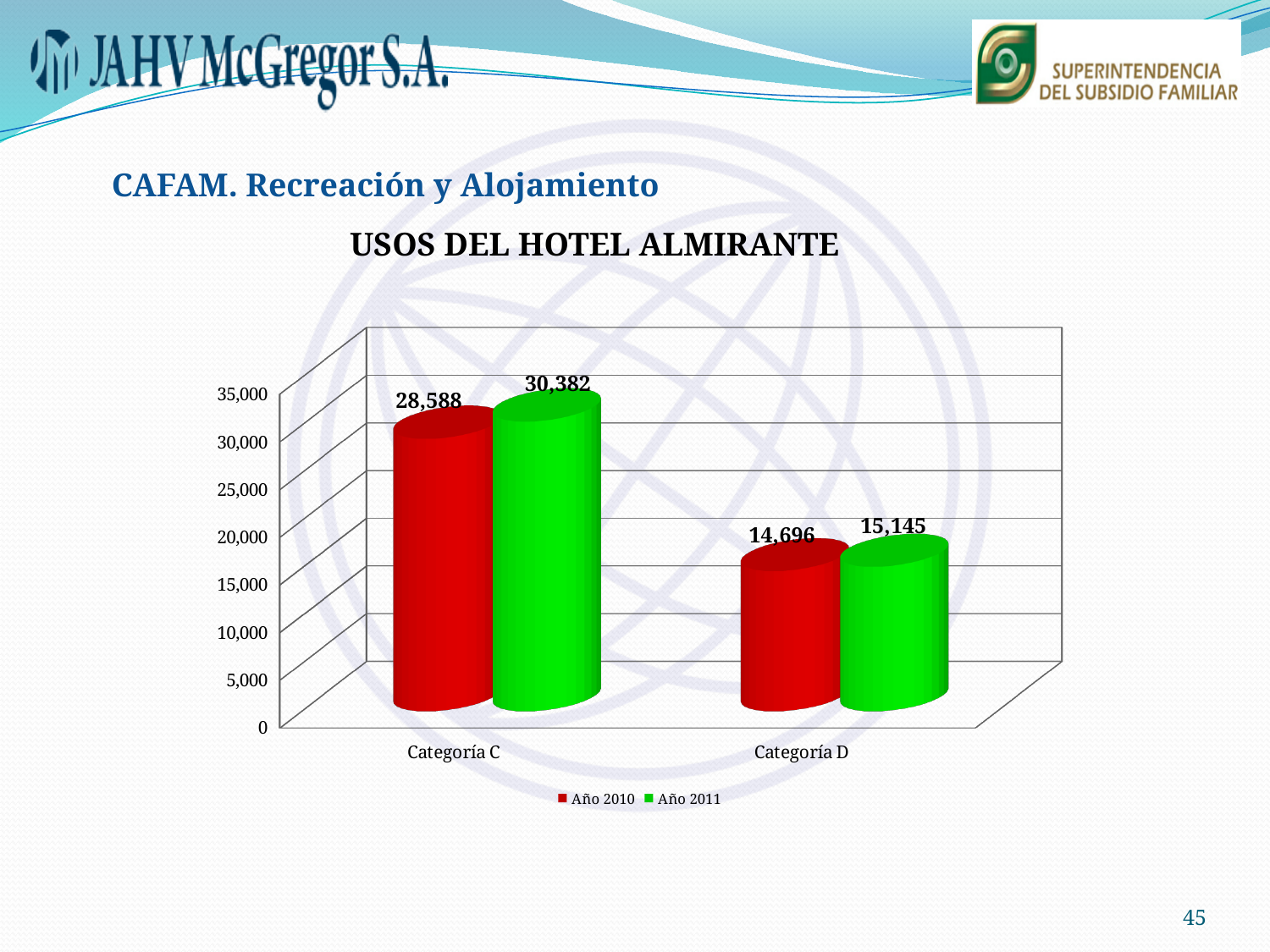
Which category has the lowest value in Año 2010? Categoría D What is the difference between the Año 2011 and Año 2010 values for Categoría C? 1,794 How many series does the legend list? 2 Which is larger for Categoría D: Año 2010 or Año 2011? Año 2011 What is the value for Categoría D in Año 2011? 15,145 What is the value for Categoría C in Año 2011? 30,382 What is the title of the chart? USOS DEL HOTEL ALMIRANTE How many categories are shown on the x axis? 2 What is the difference between the Año 2011 and Año 2010 values for Categoría D? 449 What is the value for Categoría D in Año 2010? 14,696 What is the value for Categoría C in Año 2010? 28,588 Which category has the highest value in Año 2011? Categoría C